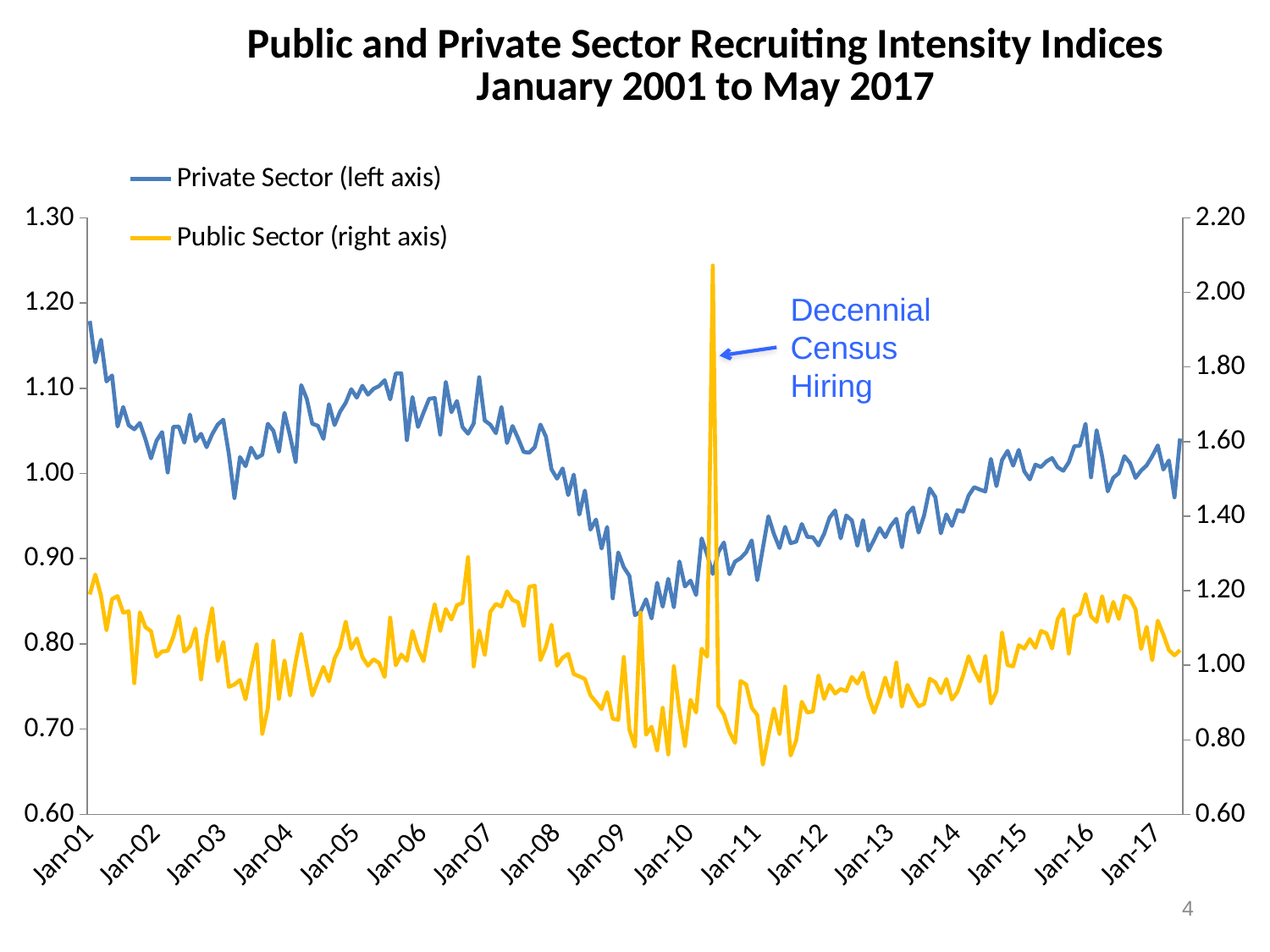
What event does the annotation attribute the large spike in the Public Sector series to? Decennial Census Hiring Is the Public Sector value at Jan-11 greater or less than 1.00 on the right axis? less Which series shows the single sharp spike around 2010? Public Sector How many series does the legend list? 2 Is the Private Sector value at Jan-01 greater or less than 1.10? greater Which axis is the Public Sector series plotted against, according to the legend? right axis Is the Private Sector value at Jan-10 greater or less than 0.90? less What kind of chart is shown on the slide? line chart Does the Private Sector series rise or fall overall between Jan-10 and Jan-17? rise Does the Private Sector series rise or fall between Jan-08 and Jan-09? fall